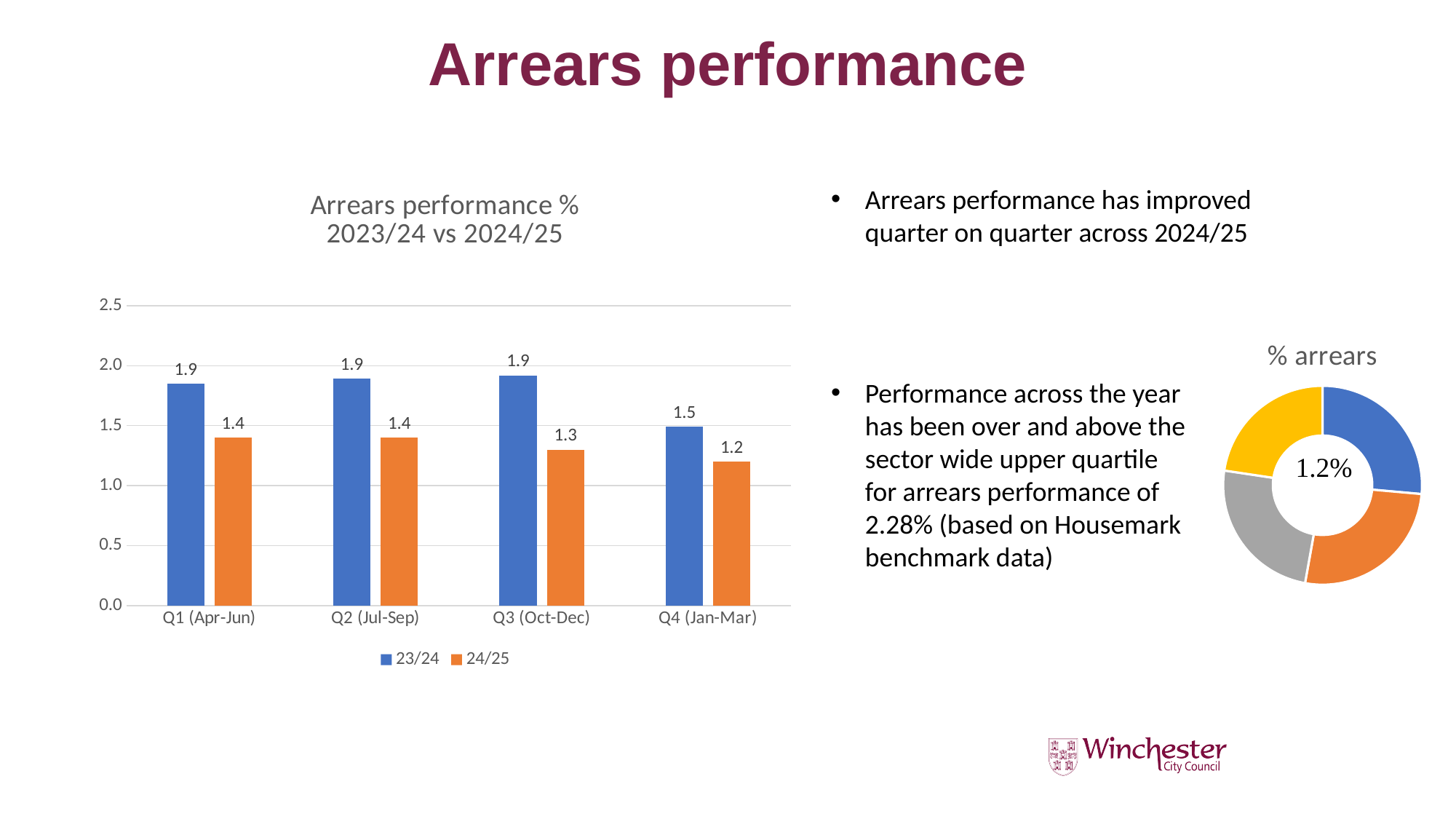
In the 'Arrears performance % 2023/24 vs 2024/25' chart, which quarter has the lowest 23/24 value? Q4 (Jan-Mar) In the 'Arrears performance % 2023/24 vs 2024/25' chart, what is the difference between the 23/24 and 24/25 values for Q1 (Apr-Jun)? 0.5 In the 'Arrears performance % 2023/24 vs 2024/25' chart, what is the difference between the 23/24 and 24/25 values for Q4 (Jan-Mar)? 0.3 In the 'Arrears performance % 2023/24 vs 2024/25' chart, do the 24/25 values rise or fall from Q1 to Q4? Fall In the 'Arrears performance % 2023/24 vs 2024/25' chart, what is the 24/25 value for Q3 (Oct-Dec)? 1.3 In the 'Arrears performance % 2023/24 vs 2024/25' chart, what is the 23/24 value for Q4 (Jan-Mar)? 1.5 In the 'Arrears performance % 2023/24 vs 2024/25' chart, which quarter has the lowest 24/25 value? Q4 (Jan-Mar) How many quarters are shown on the x axis of the 'Arrears performance % 2023/24 vs 2024/25' chart? 4 In the 'Arrears performance % 2023/24 vs 2024/25' chart, which series has the larger value for Q3 (Oct-Dec), 23/24 or 24/25? 23/24 In the 'Arrears performance % 2023/24 vs 2024/25' chart, what is the 24/25 value for Q1 (Apr-Jun)? 1.4 How many series does the legend of the 'Arrears performance % 2023/24 vs 2024/25' chart list? 2 What kind of chart is the 'Arrears performance % 2023/24 vs 2024/25' chart? Bar chart